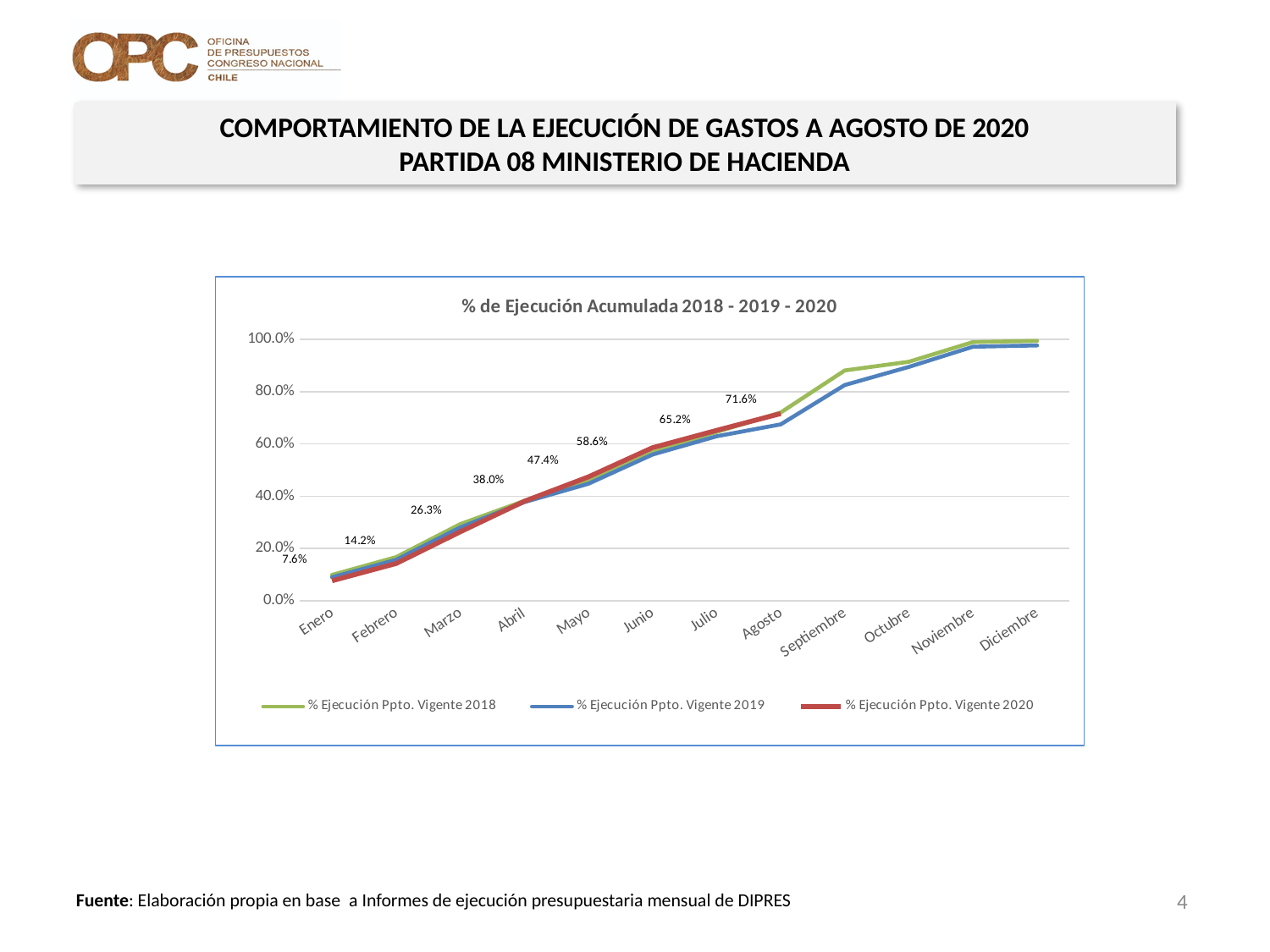
Is the value for % Ejecución Ppto. Vigente 2019 in Septiembre greater or less than 80.0%? greater What type of chart is shown on the slide? Line chart What is the value for % Ejecución Ppto. Vigente 2020 in Agosto? 71.6% How many months are shown on the x axis? 12 What is the difference between the 2020 values for Marzo and Febrero? 12.1% What is the value for % Ejecución Ppto. Vigente 2020 in Enero? 7.6% What is the difference between the 2020 values for Agosto and Julio? 6.4% What is the value for % Ejecución Ppto. Vigente 2020 in Junio? 58.6% How many series does the legend list? 3 What is the title of the chart? % de Ejecución Acumulada 2018 - 2019 - 2020 What is the value for % Ejecución Ppto. Vigente 2020 in Abril? 38.0% Do the values of the % Ejecución Ppto. Vigente 2019 series rise or fall from Enero to Diciembre? Rise